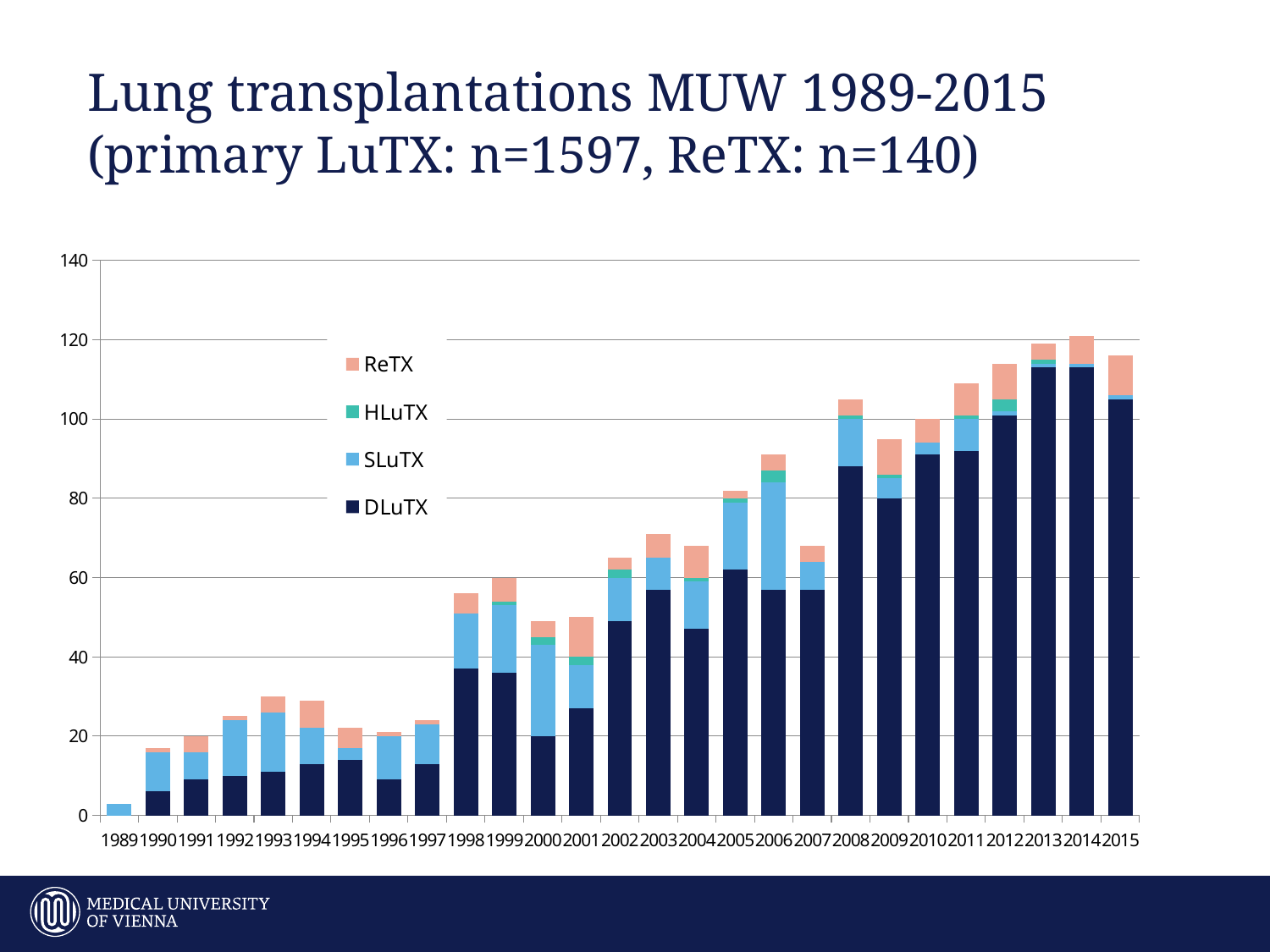
Which year has the larger total bar, 2014 or 2007? 2014 Is the total value for 2005 greater or less than 60? greater How many years are shown along the x axis of the chart? 27 Which series is shown in dark navy in the chart legend? DLuTX What kind of chart is shown on the slide? Stacked bar chart Which year has the lowest total bar in the chart? 1989 Is the total value for 2001 greater or less than 60? less Is the total value for 2015 greater or less than 100? greater How many series does the chart legend list? 4 Overall, do the total bars rise or fall from 1989 to 2015? rise